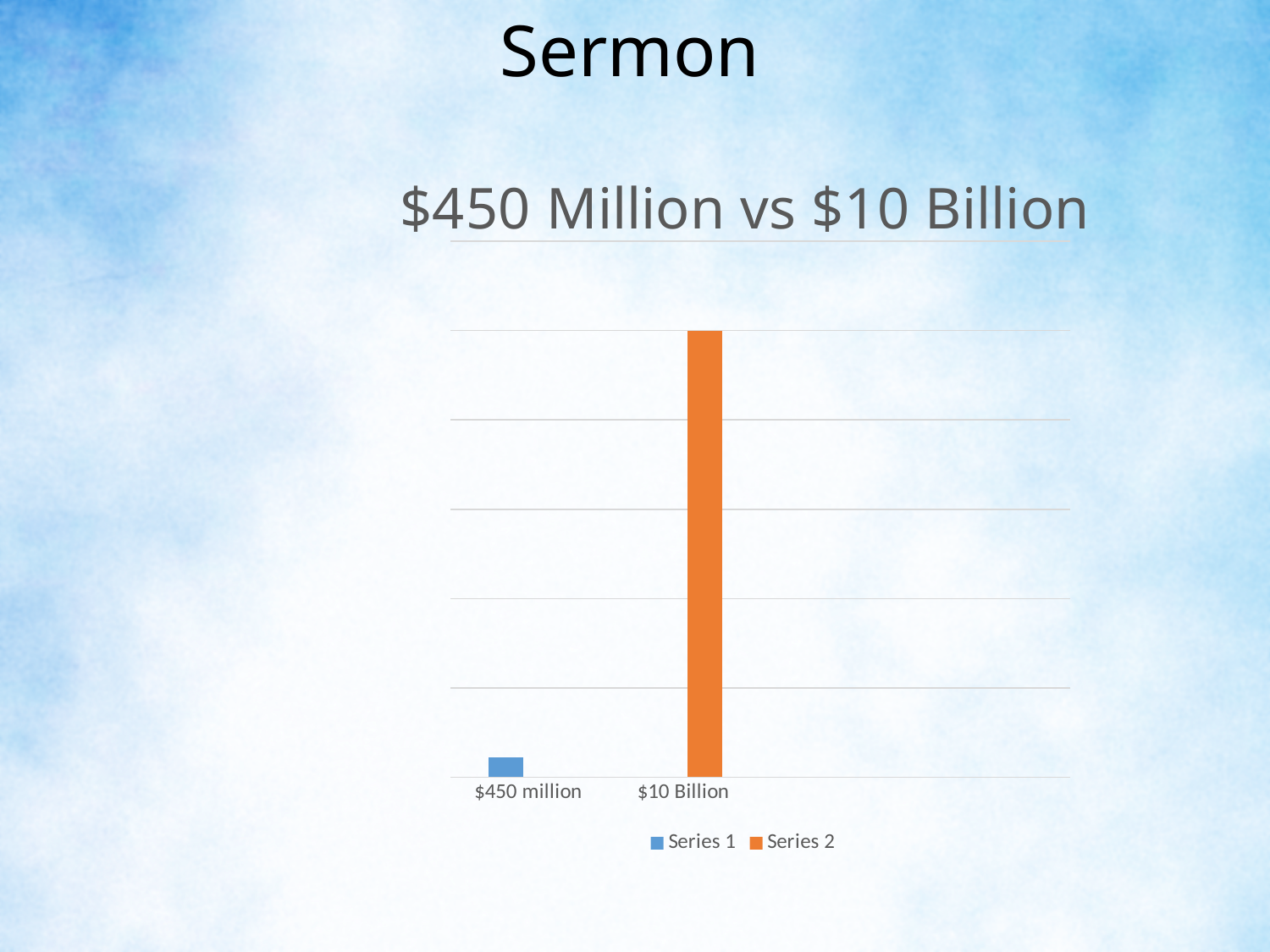
Which bar is taller, the one for $450 million or the one for $10 Billion? $10 Billion What is the title of the chart? $450 Million vs $10 Billion What are the names of the series listed in the chart legend? Series 1 and Series 2 How many series does the chart legend list? 2 What are the two category labels on the x axis of the chart? $450 million and $10 Billion Which category has the tallest bar in the chart? $10 Billion What kind of chart is shown on the slide? bar chart Which category has the shortest bar in the chart? $450 million How many categories are shown on the x axis of the chart? 2